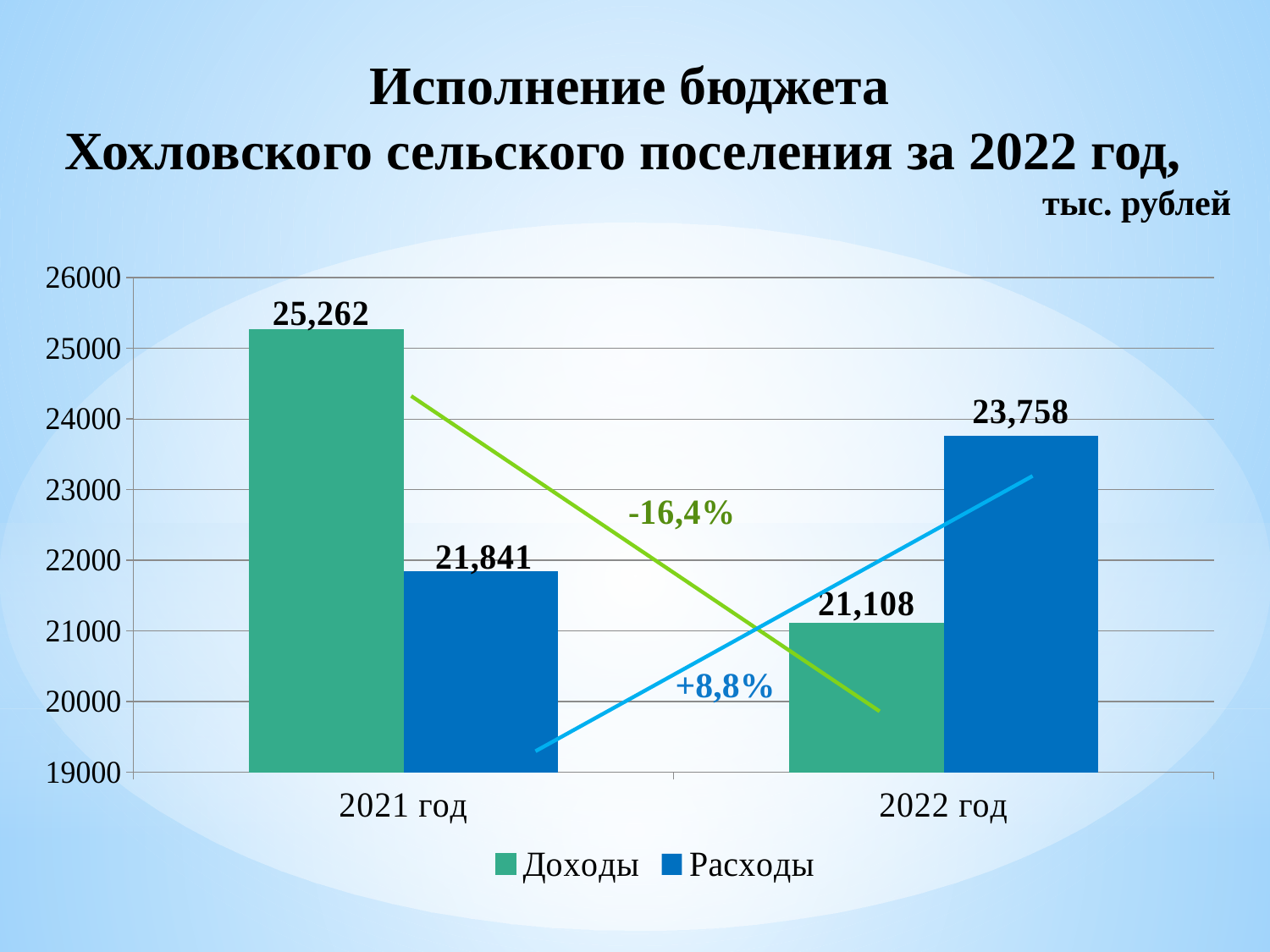
What is the value of Доходы for 2021 год? 25,262 What is the value of Расходы for 2022 год? 23,758 Which year has the highest Доходы value? 2021 год What is the value of Расходы for 2021 год? 21,841 What is the value of Доходы for 2022 год? 21,108 Which year has the lowest Расходы value? 2021 год Do the Доходы values rise or fall from 2021 год to 2022 год? Fall What percentage change is labelled on the green line between the Доходы bars? -16,4% What kind of chart is shown on the slide? Bar chart What is the difference between Доходы and Расходы in 2021 год? 3,421 How many series does the legend list? 2 Which is larger in 2022 год, Доходы or Расходы? Расходы